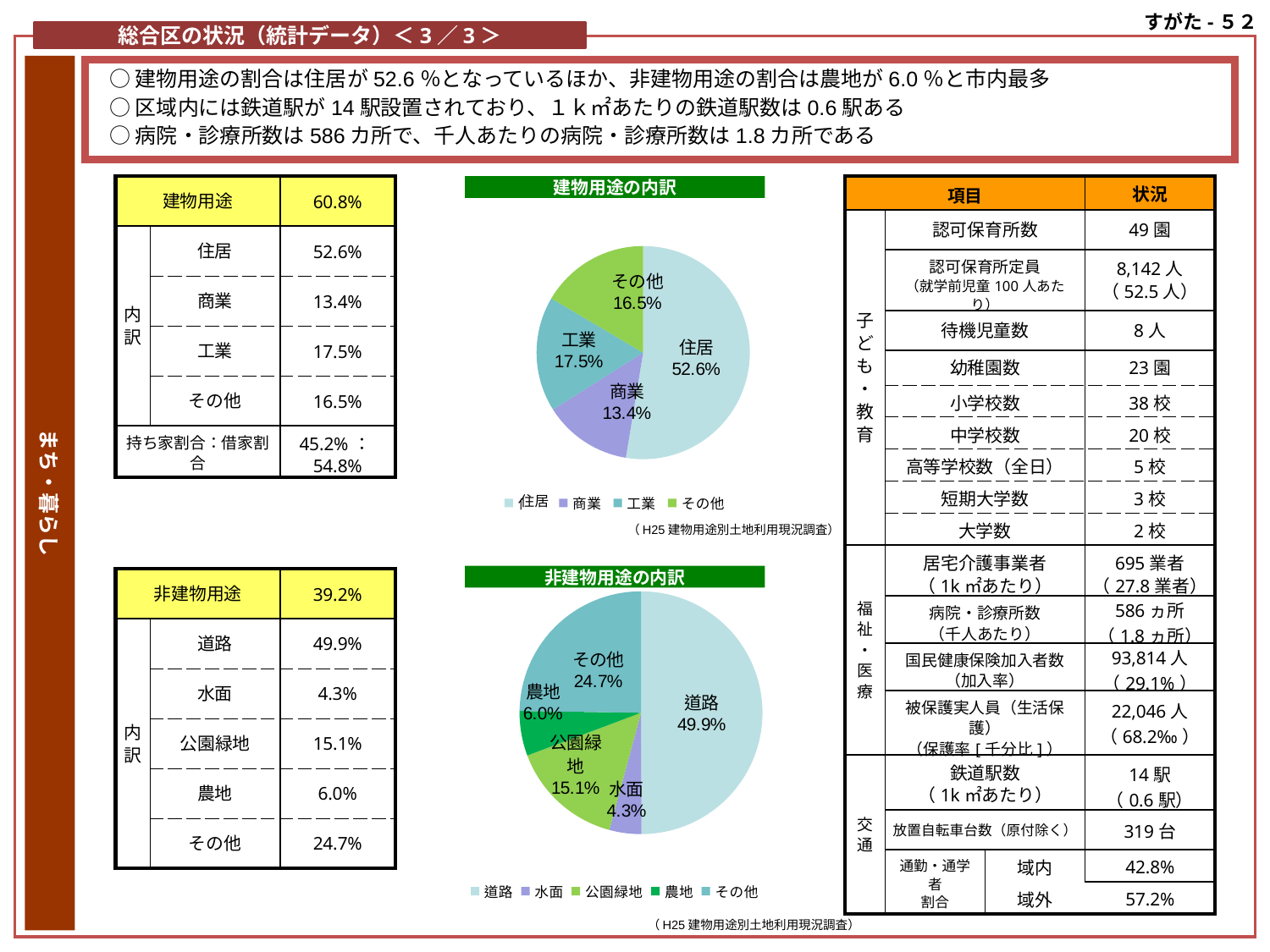
In the 非建物用途の内訳 chart, which is larger, 公園緑地 or その他? その他 In the 建物用途の内訳 chart, what is the share for 住居? 52.6% In the 建物用途の内訳 chart, what is the share for 工業? 17.5% In the 建物用途の内訳 chart, which category has the smallest share? 商業 In the 非建物用途の内訳 chart, what is the difference between the shares of その他 and 公園緑地? 9.6% In the 建物用途の内訳 chart, how many categories does the legend list? 4 In the 非建物用途の内訳 chart, what is the share for 道路? 49.9% In the 建物用途の内訳 chart, what is the difference between the shares of 工業 and 商業? 4.1% In the 非建物用途の内訳 chart, what is the share for 農地? 6.0% In the 非建物用途の内訳 chart, which category has the smallest share? 水面 In the 非建物用途の内訳 chart, how many categories does the legend list? 5 What type of chart is the 建物用途の内訳 chart? pie chart